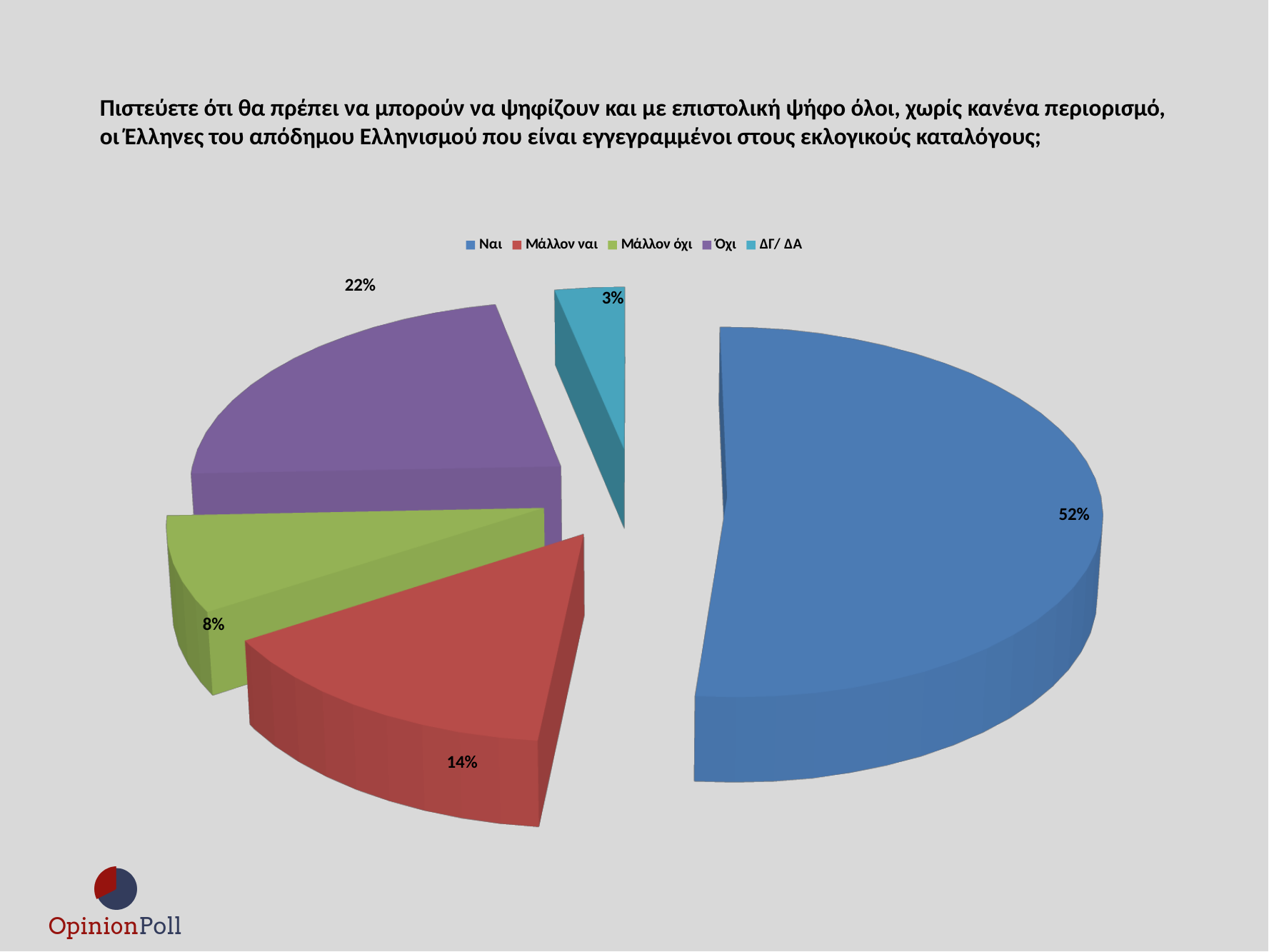
Which response category has the smallest share of the pie? ΔΓ/ ΔΑ What percentage of respondents answered "Μάλλον ναι"? 14% What percentage of respondents answered "Όχι"? 22% How many categories does the legend list? 5 What colour is the slice for "Όχι"? Purple What percentage of respondents answered "Ναι"? 52% What type of chart is shown on the slide? Pie chart What percentage of respondents answered "Μάλλον όχι"? 8% Which response category has the largest share of the pie? Ναι What percentage of respondents answered "ΔΓ/ ΔΑ"? 3% Which is larger, the share for "Μάλλον ναι" or the share for "Μάλλον όχι"? Μάλλον ναι What is the difference in percentage points between "Ναι" and "Όχι"? 30